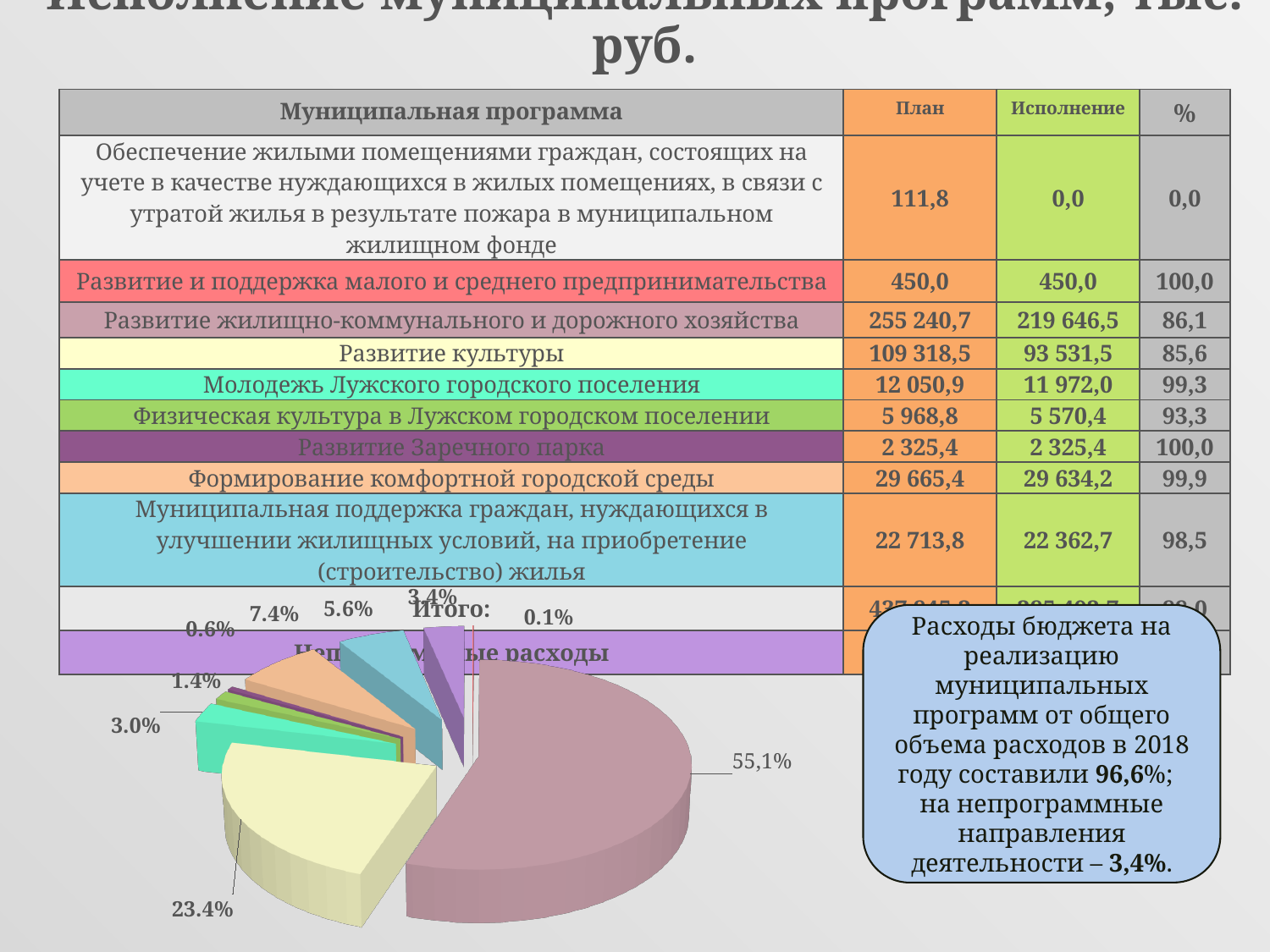
What kind of chart is shown at the bottom left of the slide? pie chart What colour is the largest slice of the pie chart? pink (mauve) In the pie chart, what is the value of the largest slice? 55,1% In the pie chart, what is the difference in percentage points between the largest slice (55,1%) and the pale yellow slice (23.4%)? 31.7 In the pie chart, what is the value of the pale yellow slice? 23.4% Does the pie chart have a legend? No How many slices in the pie chart have a data label? 9 In the pie chart, which is larger: the slice labelled 3.0% or the slice labelled 1.4%? 3.0% In the pie chart, which is larger: the slice labelled 7.4% or the slice labelled 5.6%? 7.4% In the pie chart, what is the value of the smallest labelled slice? 0.1%